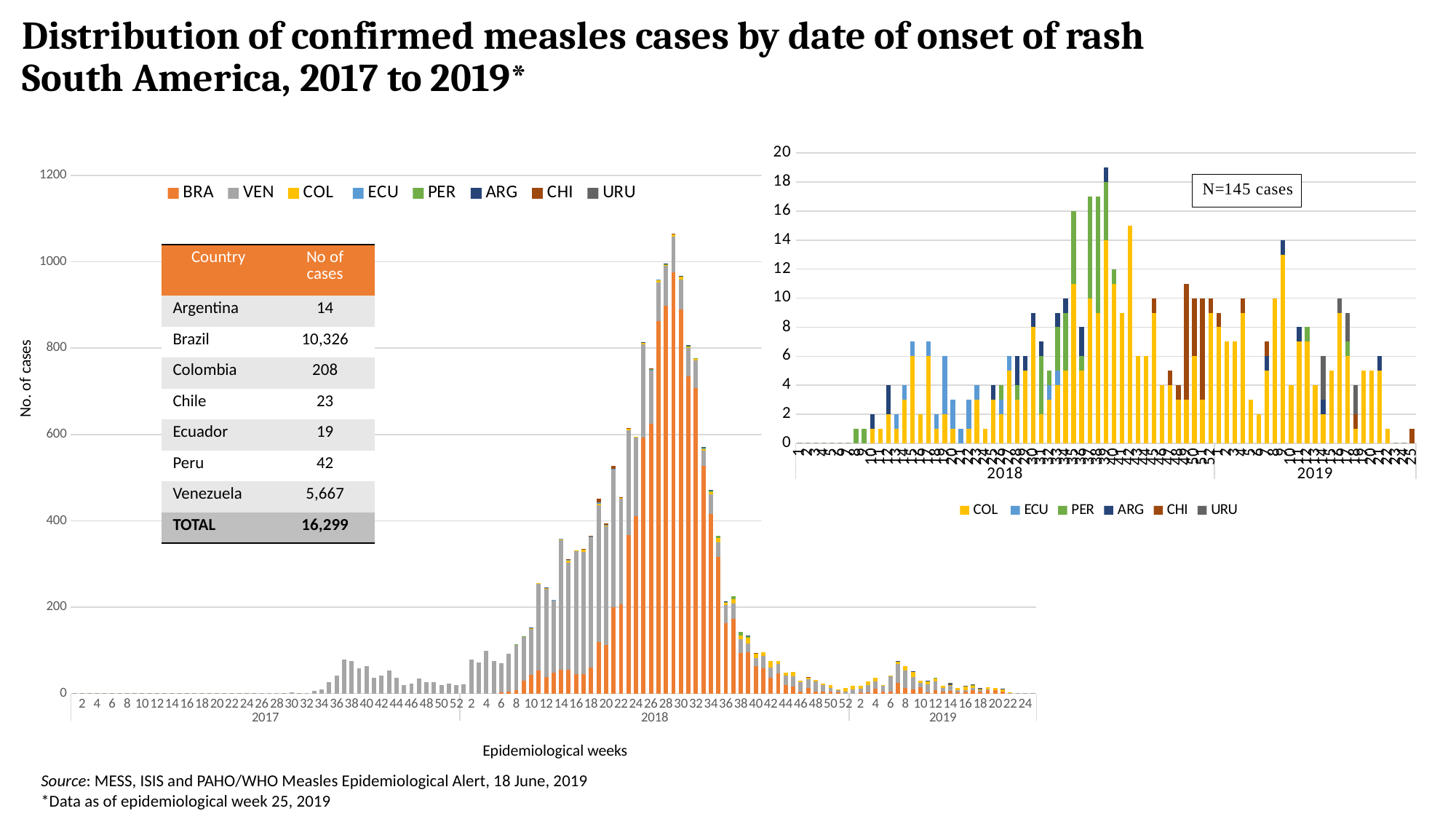
In the large chart on the left, is the value of the tallest bar (around week 28 of 2018) greater or less than 1000? greater What kind of chart is the large chart on the left of the slide? bar chart In the inset chart in the top right, is the value of the tallest bar greater or less than 16? greater In the large chart on the left, is the value for week 2 of 2017 greater or less than 200? less In the inset chart in the top right, which series is shown in yellow? COL What total number of cases is stated in the annotation on the inset chart in the top right? N=145 cases In the large chart on the left, which series is shown in orange? BRA What is the x-axis title of the large chart on the left? Epidemiological weeks How many series does the legend of the inset chart in the top right list? 6 How many series does the legend of the large chart on the left list? 8 In the large chart on the left, do the bar heights rise or fall from week 28 of 2018 to week 52 of 2018? fall In the large chart on the left, which year contains the tallest bars: 2017, 2018 or 2019? 2018